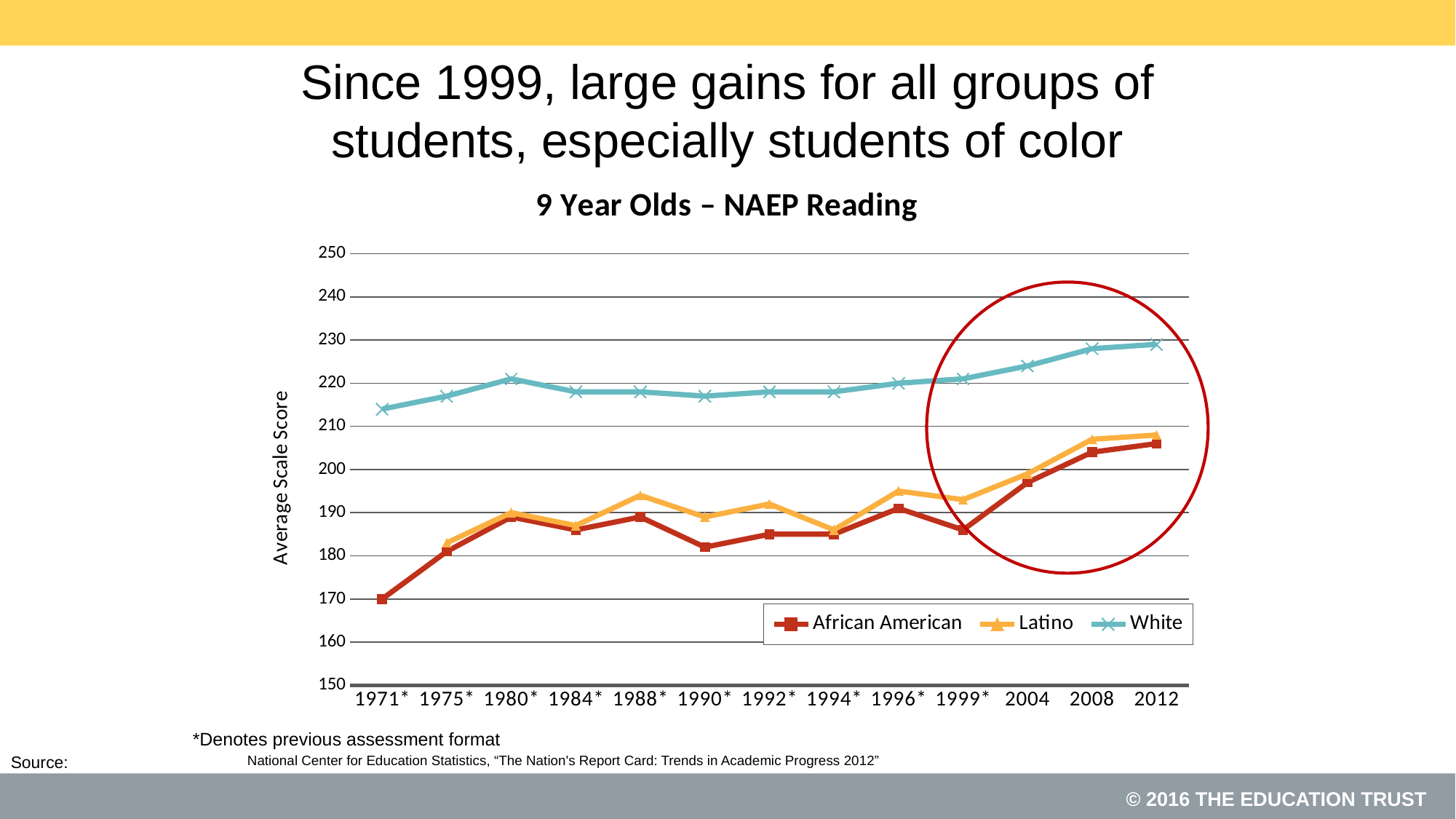
What is the African American average scale score in 1971*? 170 What is the label on the vertical axis? Average Scale Score Is the White average scale score in 2012 greater or less than 220? greater Does the African American average scale score rise or fall from 1999* to 2012? rise Is the Latino average scale score in 2012 greater or less than 200? greater How many series does the legend list? 3 What is the chart's title? 9 Year Olds – NAEP Reading What type of chart is shown on the slide? Line chart Which group has the lowest average scale score in 1990*? African American Which group has the highest average scale score in 2012? White How many years are shown along the x axis? 13 Is the African American average scale score in 1990* greater or less than 190? less